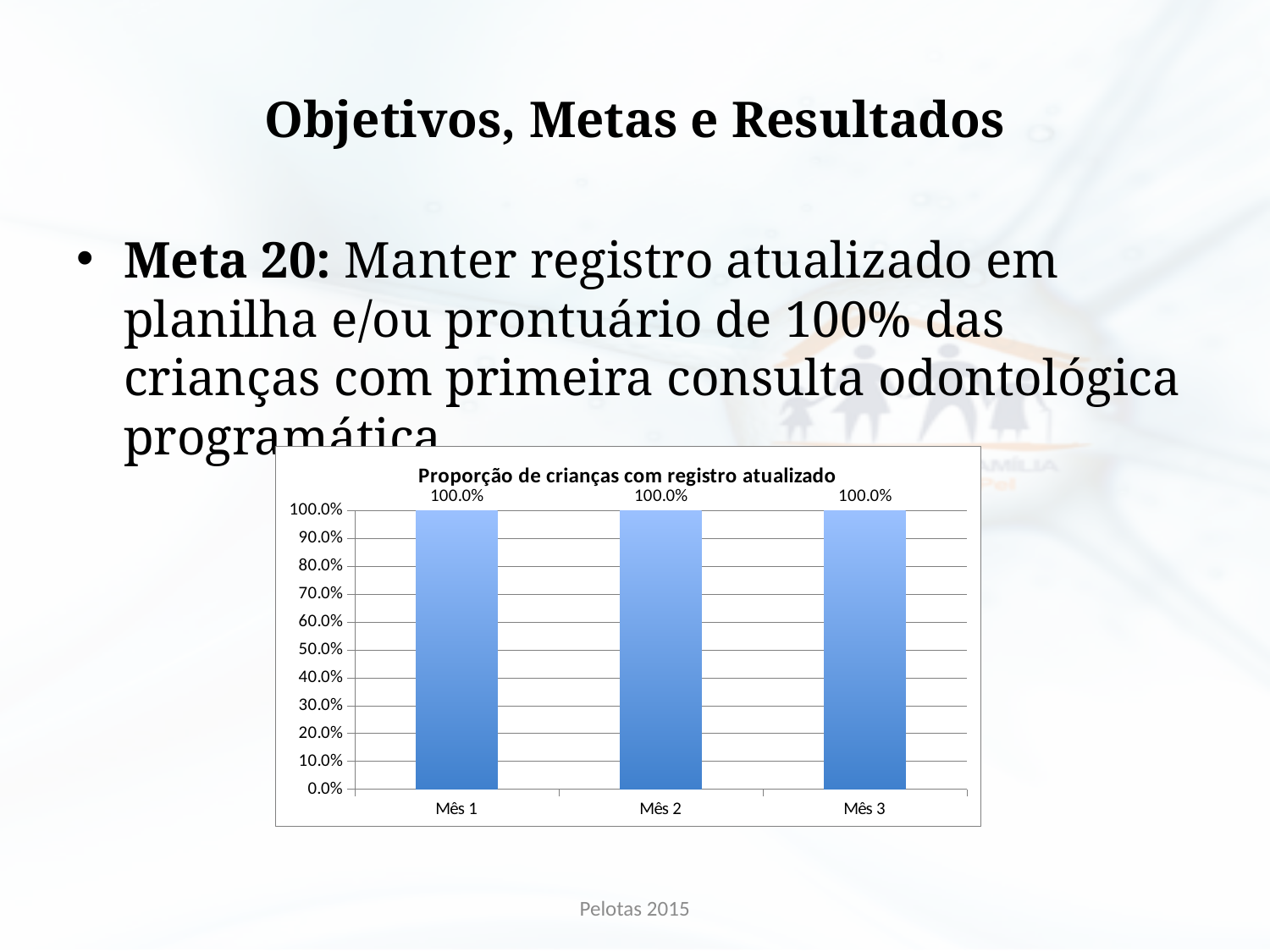
What is the difference between the values for Mês 1 and Mês 3? 0.0% What kind of chart is shown on the slide? Bar chart What is the value for Mês 2 in the chart? 100.0% What is the highest value shown on the y axis of the chart? 100.0% What is the value for Mês 1 in the chart? 100.0% What is the value for Mês 3 in the chart? 100.0% What is the title of the chart? Proporção de crianças com registro atualizado Do the values rise, fall or stay the same from Mês 1 to Mês 3? Stay the same Is the value for Mês 2 greater or less than 90.0%? greater How many categories are shown on the x axis of the chart? 3